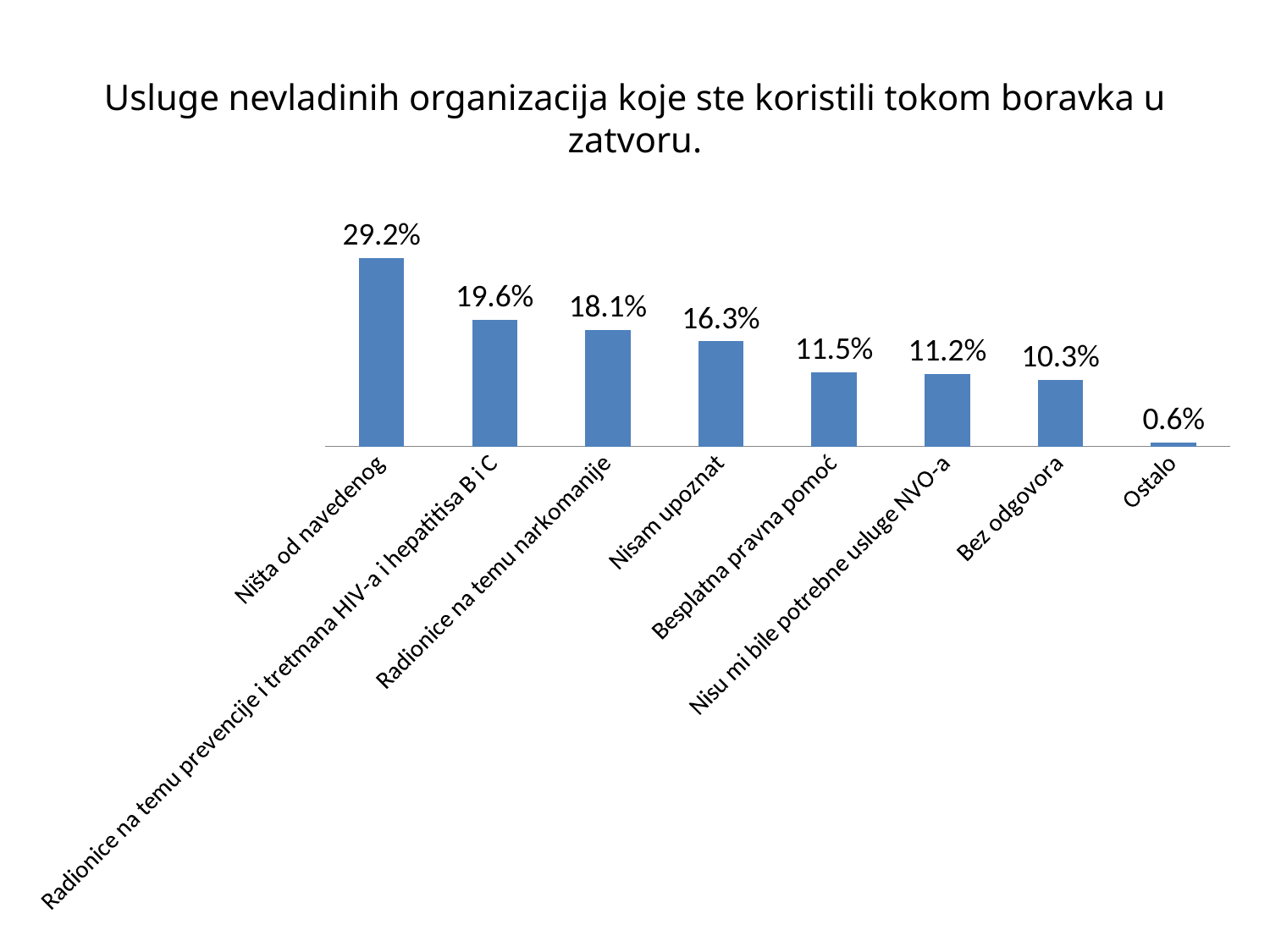
What kind of chart is shown on the slide? Bar chart Do the values rise or fall from left to right along the x axis? Fall What is the value for "Ostalo"? 0.6% Which category has the lowest value? Ostalo What is the value for "Ništa od navedenog"? 29.2% Which category has the highest value? Ništa od navedenog How many categories are shown in the chart? 8 Which is larger: "Radionice na temu narkomanije" or "Bez odgovora"? Radionice na temu narkomanije What is the value for "Besplatna pravna pomoć"? 11.5% What is the difference between "Ništa od navedenog" and "Radionice na temu prevencije i tretmana HIV-a i hepatitisa B i C"? 9.6% What is the value for "Nisam upoznat"? 16.3% What is the title of the chart? Usluge nevladinih organizacija koje ste koristili tokom boravka u zatvoru.